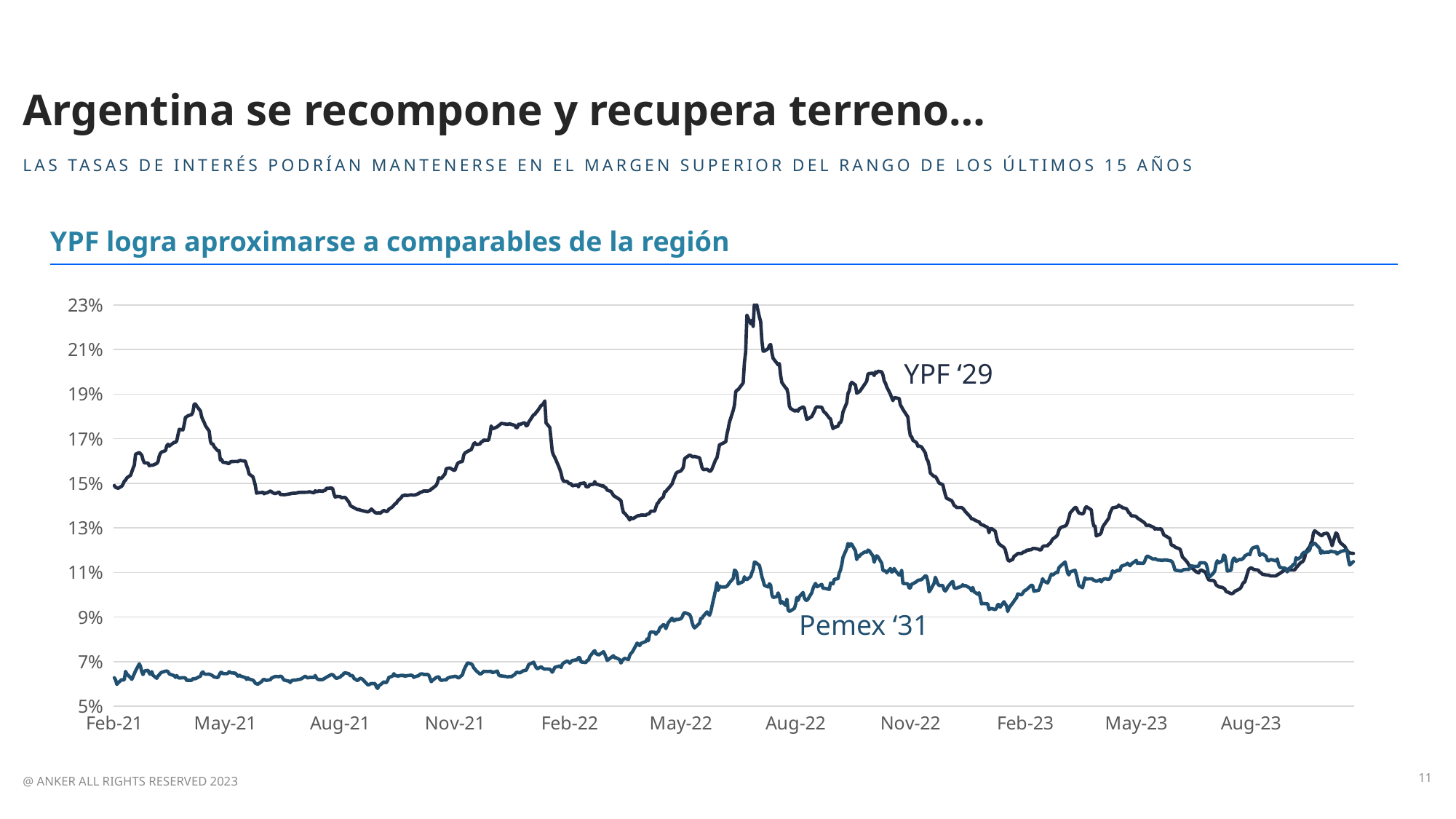
Is the value of Pemex '31 at May-23 greater or less than 9%? greater Is the value of YPF '29 at May-21 greater or less than 15%? greater Does the Pemex '31 series rise or fall between Feb-21 and Aug-22? rise Which series is higher at Aug-22, YPF '29 or Pemex '31? YPF '29 Which series reaches the highest value on the chart? YPF '29 What kind of chart is shown on the slide? line chart Which two series are labelled on the chart? YPF '29 and Pemex '31 Is the peak value of the YPF '29 series greater or less than 21%? greater How many series are plotted on the chart? 2 What is the title of the chart? YPF logra aproximarse a comparables de la región